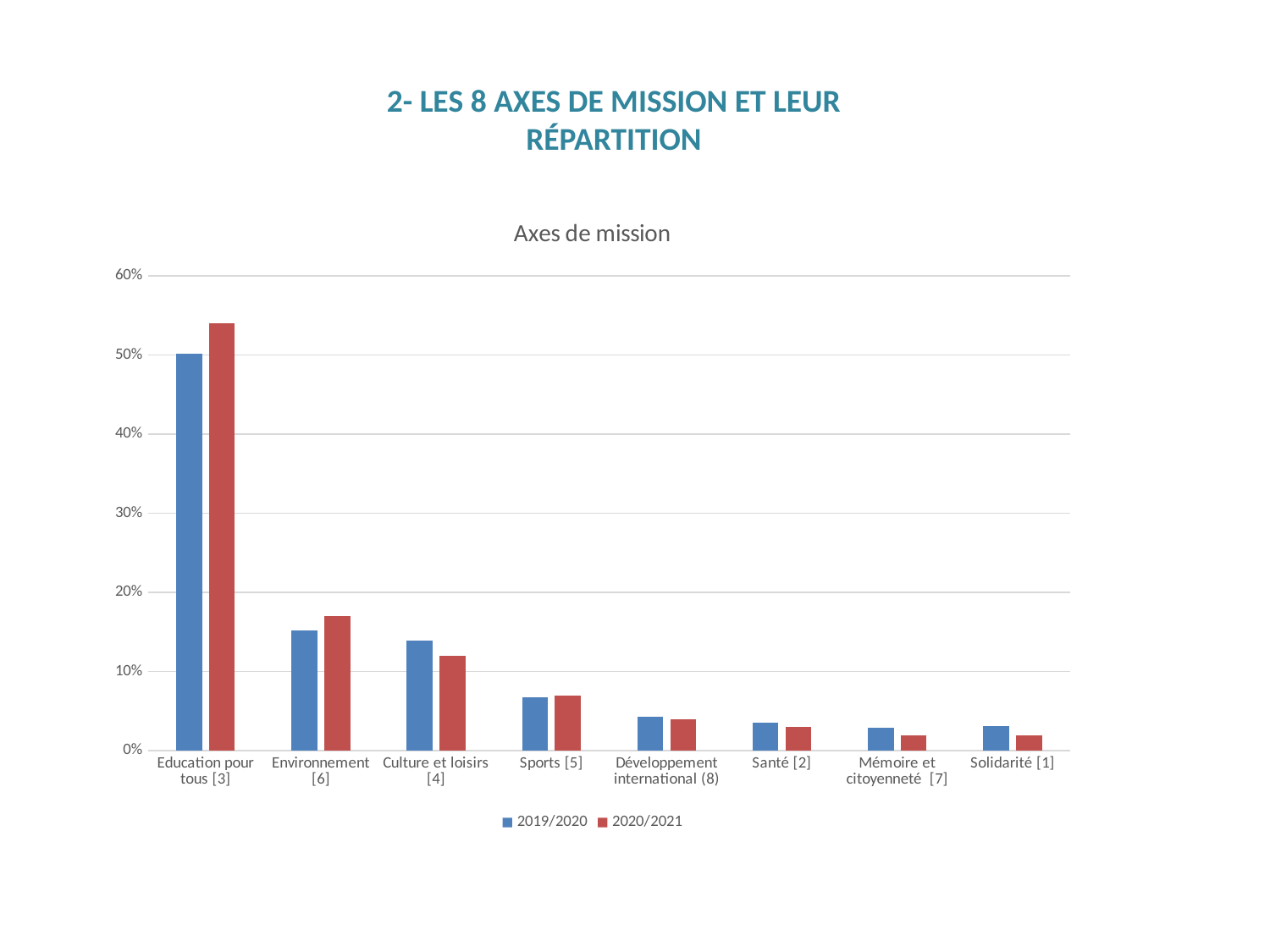
Is the 2020/2021 value for Education pour tous [3] greater or less than 50%? greater Is the 2019/2020 value for Environnement [6] greater or less than 20%? less Is the 2019/2020 value for Sports [5] greater or less than 10%? less Which category has the highest value for the 2019/2020 series? Education pour tous [3] How many series does the chart's legend list? 2 For Education pour tous [3], which series has the larger value, 2019/2020 or 2020/2021? 2020/2021 How many categories are shown on the x axis of the chart? 8 For Culture et loisirs [4], which series has the larger value, 2019/2020 or 2020/2021? 2019/2020 What is the title of the chart? Axes de mission Which category has the highest value for the 2020/2021 series? Education pour tous [3] What kind of chart is shown on the slide? bar chart